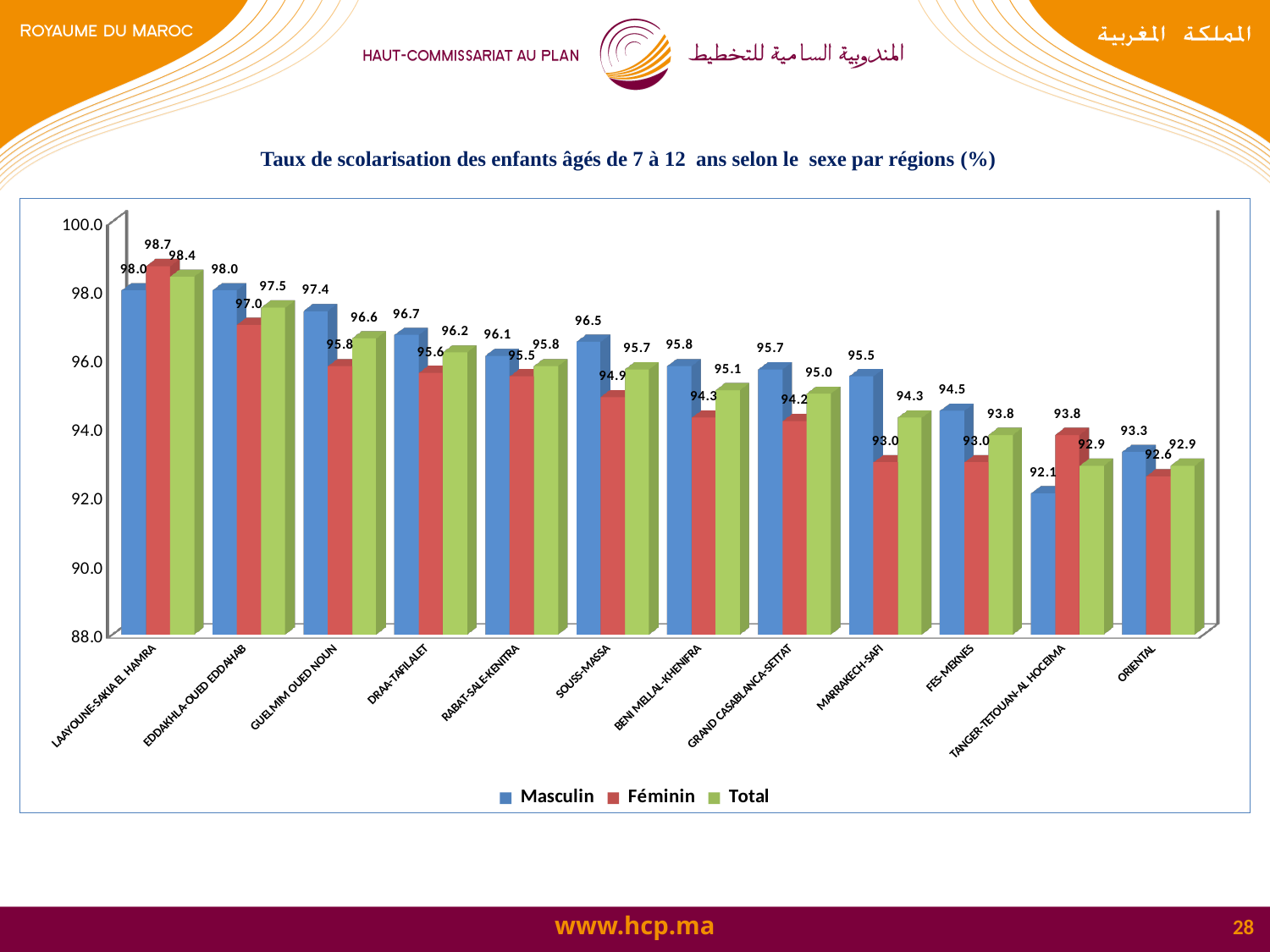
What is the Masculin value for GUELMIM OUED NOUN? 97.4 What is the Féminin value for MARRAKECH-SAFI? 93.0 How many series does the legend list? 3 What is the Total value for SOUSS-MASSA? 95.7 How many regions are shown on the x axis? 12 Which series is shown in green in the legend? Total Which is larger for TANGER-TETOUAN-AL HOCEIMA, the Masculin value or the Féminin value? Féminin Which region has the lowest Masculin value? TANGER-TETOUAN-AL HOCEIMA What kind of chart is shown on the slide? Bar chart What is the difference between the Masculin and Féminin values for MARRAKECH-SAFI? 2.5 Is the Total value for FES-MEKNES greater or less than 94.0? less Which region has the highest Féminin value? LAAYOUNE-SAKIA EL HAMRA